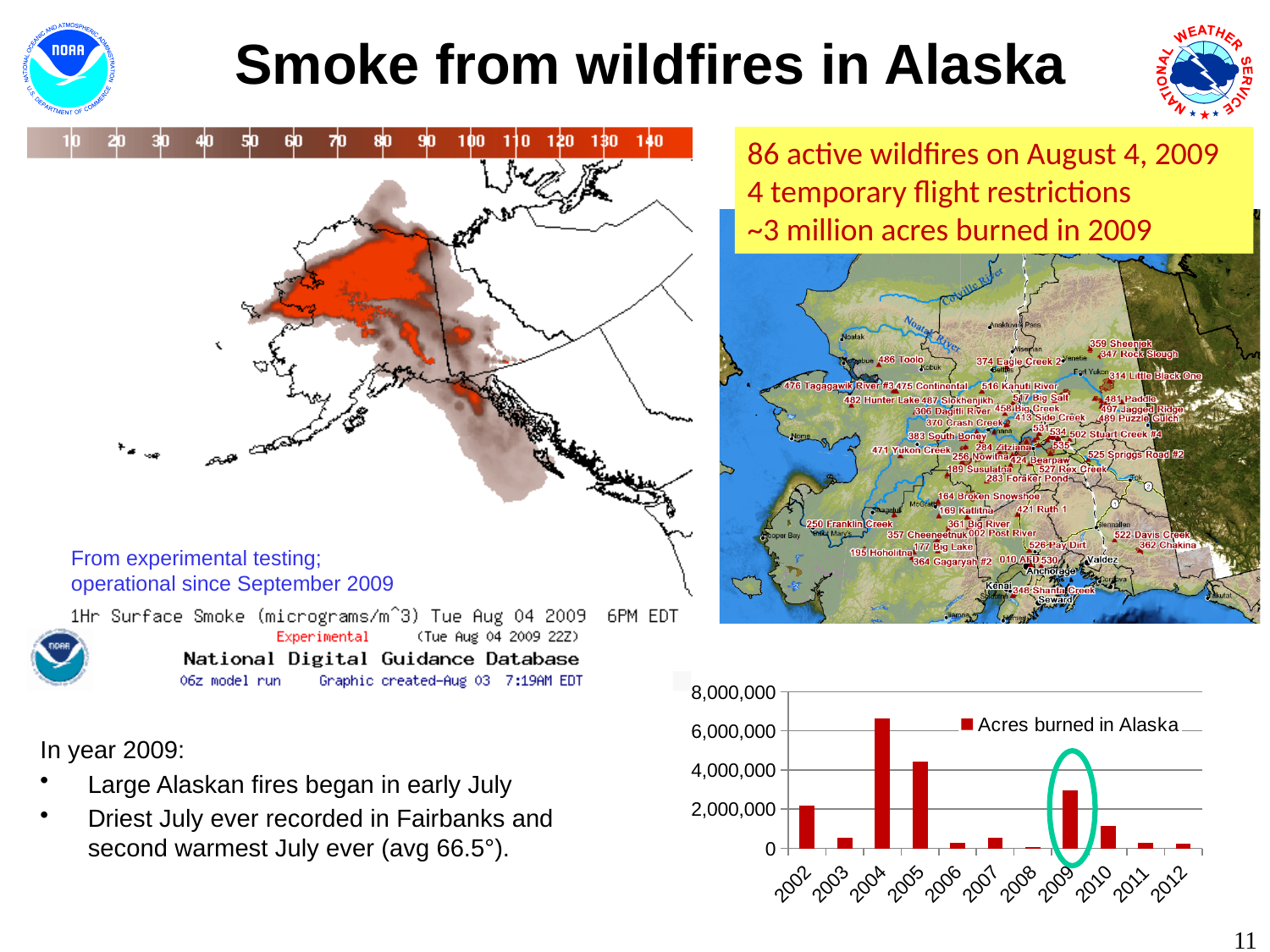
In the bar chart at the bottom right, is the value for 2010 greater or less than 2,000,000? less In the bar chart at the bottom right, is the value for 2004 greater or less than 6,000,000? greater In the bar chart at the bottom right, which year has the lowest acres burned in Alaska? 2008 In the bar chart at the bottom right, which year had more acres burned, 2009 or 2010? 2009 In the bar chart at the bottom right, how many years are shown on the x axis? 11 What is the legend entry of the bar chart at the bottom right of the slide? Acres burned in Alaska In the bar chart at the bottom right, which year has the highest acres burned in Alaska? 2004 In the bar chart at the bottom right, is the value for 2009 greater or less than 2,000,000? greater How many series does the legend of the bar chart at the bottom right list? 1 What kind of chart is the chart at the bottom right of the slide? Bar chart In the bar chart at the bottom right, which year had more acres burned, 2004 or 2005? 2004